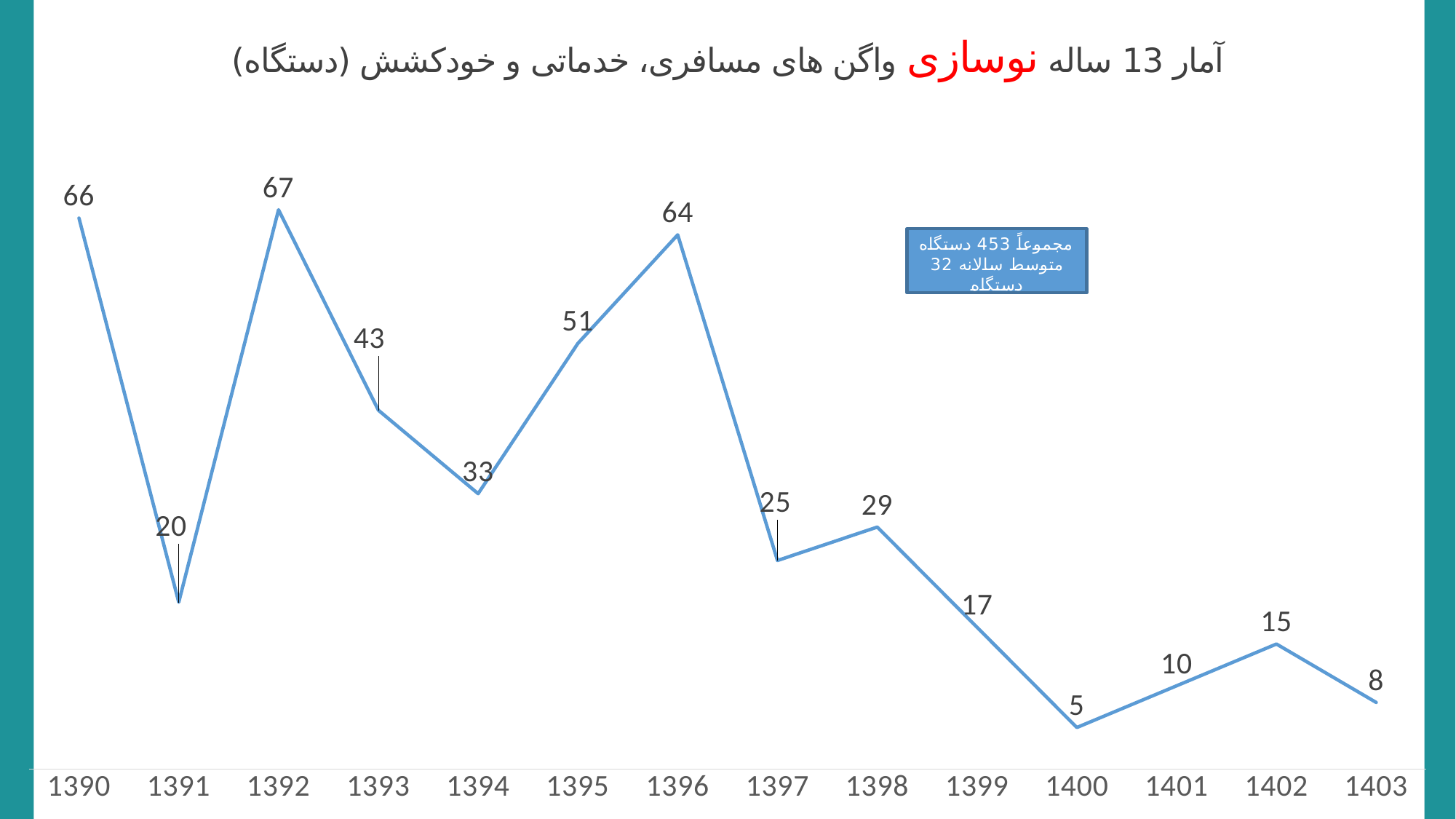
What is the value for 1392? 67 What is the difference between the values for 1390 and 1391? 46 What kind of chart is shown on the slide? Line chart Do the values generally rise or fall from 1396 to 1400? Fall What is the value for 1400? 5 What annual average does the text box on the chart state? 32 Which is larger, the value for 1393 or the value for 1394? 1393 Which year has the highest value? 1392 What is the value for 1396? 64 How many years are plotted on the x axis? 14 What total number of units does the text box on the chart state? 453 Which year has the lowest value? 1400